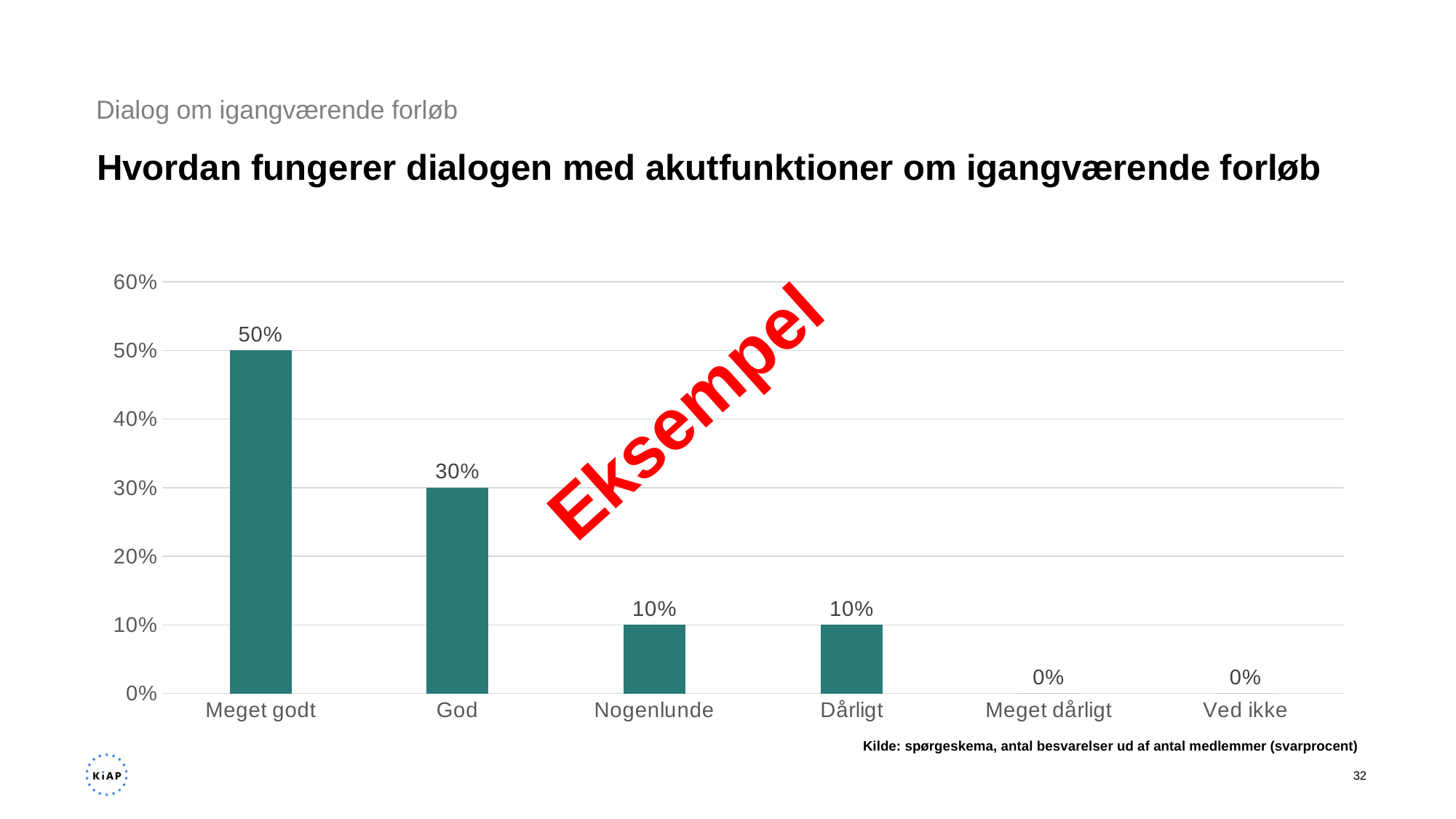
How many categories are shown on the x axis? 6 What is the value for God? 30% What is the value for Meget godt? 50% What is the value for Ved ikke? 0% What is the highest value shown on the y axis? 60% Which is larger, the value for God or the value for Dårligt? God What is the difference between the values for Meget godt and God? 20% What kind of chart is shown on the slide? Bar chart Is the value for Meget godt greater or less than 40%? greater What is the value for Nogenlunde? 10% Which category has the highest value? Meget godt Do the values rise or fall from Meget godt to Ved ikke along the x axis? Fall